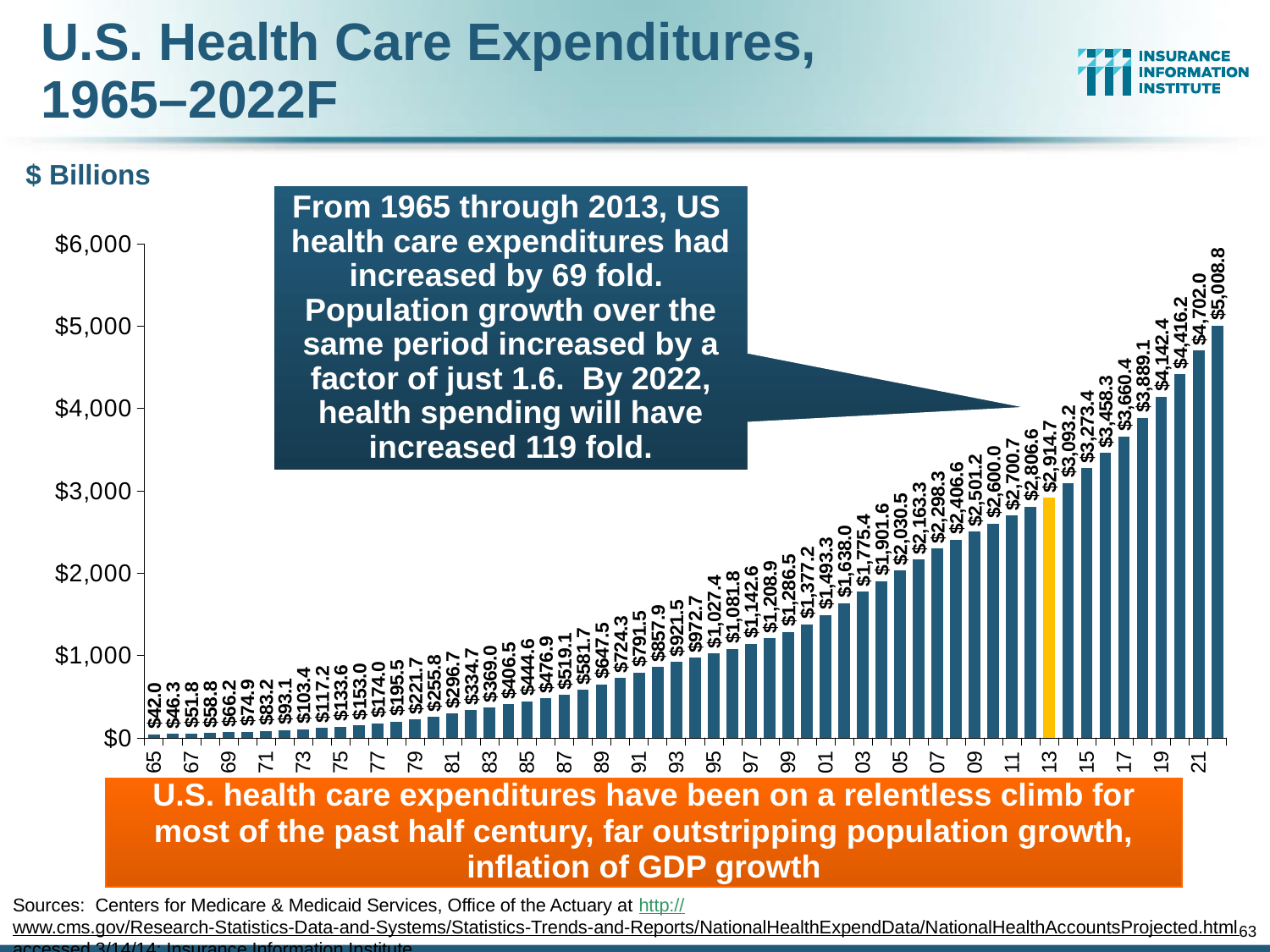
What is the highest value shown on the chart? $5,008.8 In what unit are the values on the y axis expressed? $ Billions Which is larger, the value for 1995 ($1,027.4) or the value for 1990 ($724.3)? 1995 ($1,027.4) What value is shown for the year 2000 (label '01' is the following bar)? $1,377.2 What value does the chart show for 2013, the highlighted bar? $2,914.7 Do the values rise or fall from left to right along the x axis? Rise What was U.S. health care expenditure in 1965 according to the chart? $42.0 What is the forecast value for 2022 shown at the right end of the chart? $5,008.8 What kind of chart is shown on the slide? Bar chart Is the value for 2005 greater or less than $2,000? greater What is the difference between the 2022 forecast ($5,008.8) and the 2013 value ($2,914.7)? $2,094.1 What is the lowest value shown on the chart? $42.0